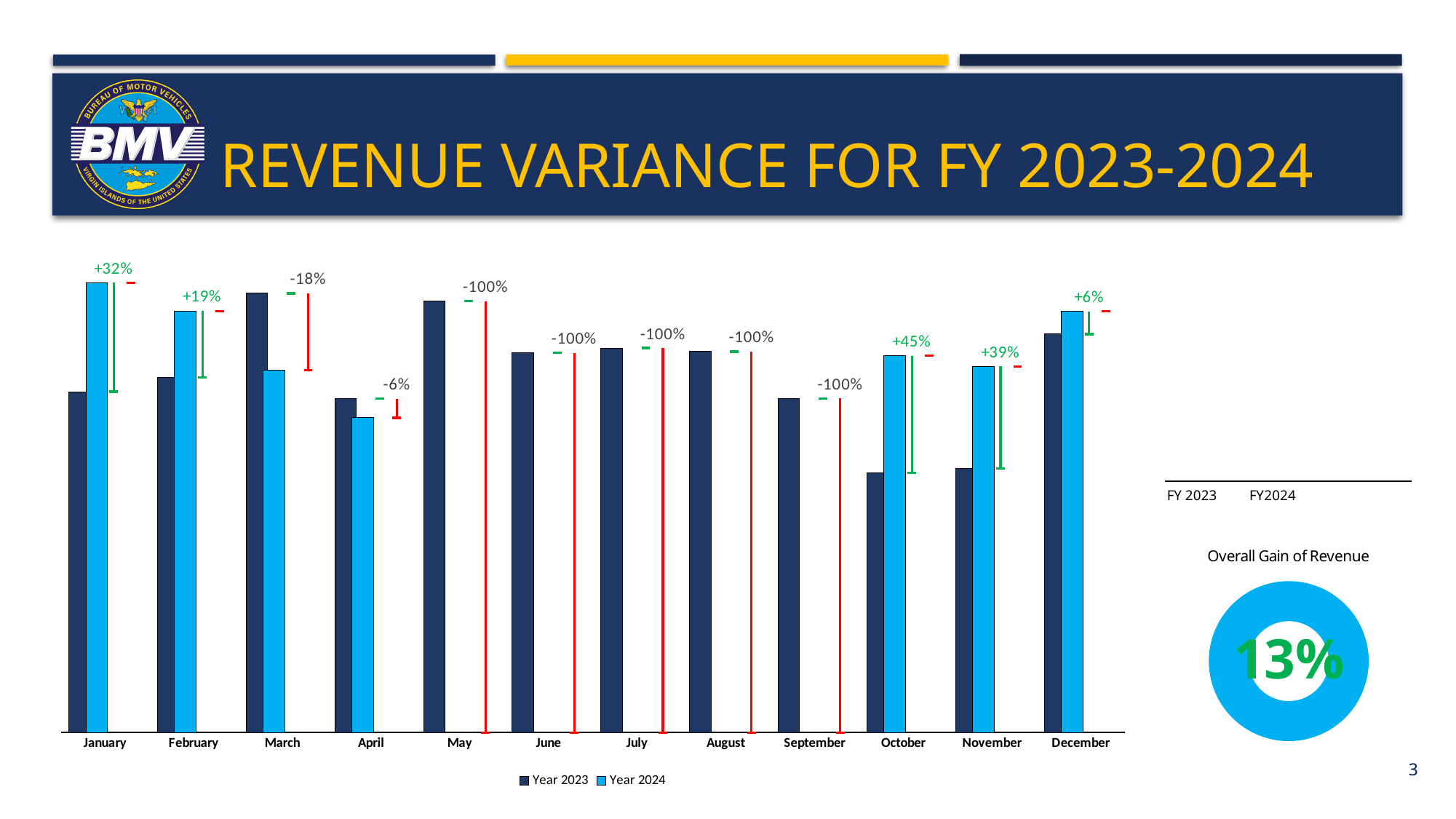
What overall gain of revenue is shown in the circle on the right of the slide? 13% Which month has the highest positive variance label on the chart? October What variance percentage is labelled for March? -18% How many series does the chart legend list? 2 In February, which bar is taller: Year 2023 or Year 2024? Year 2024 How many months are labelled with a -100% variance? 5 What variance percentage is labelled for October? +45% How many months are shown along the x axis of the chart? 12 In April, which bar is taller: Year 2023 or Year 2024? Year 2023 What kind of chart is shown on the slide? bar chart What variance percentage is labelled for January? +32% What variance percentage is labelled for December? +6%